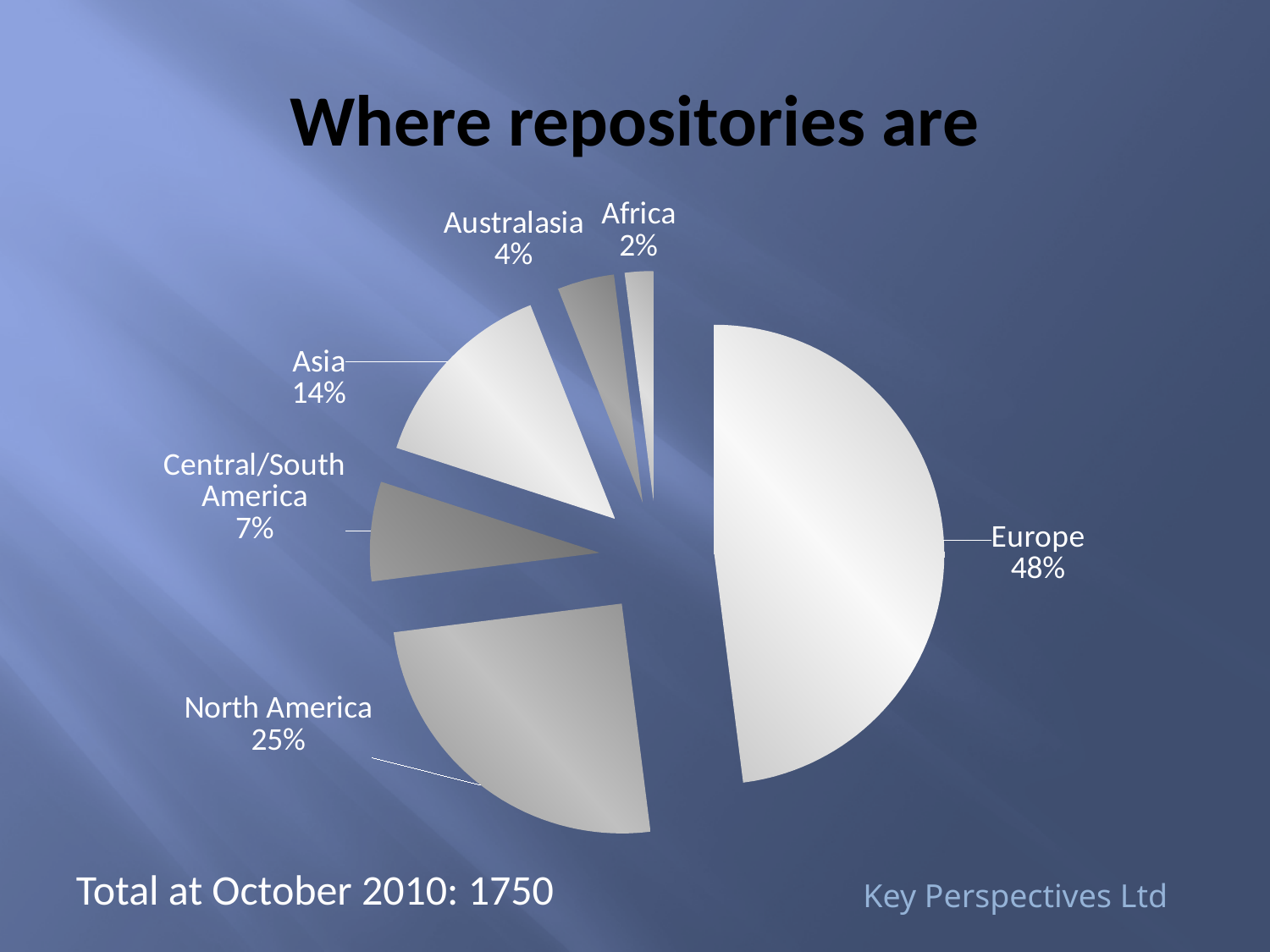
What type of chart is shown on the slide? Pie chart Which region has the smallest share of repositories? Africa How many regions are shown in the pie chart? 6 What share of repositories is in Africa? 2% Which region has the largest share of repositories? Europe How many percentage points larger is Europe's share than North America's? 23 What share of repositories is in Australasia? 4% What share of repositories is in Asia? 14% Which has a larger share, Asia or Central/South America? Asia